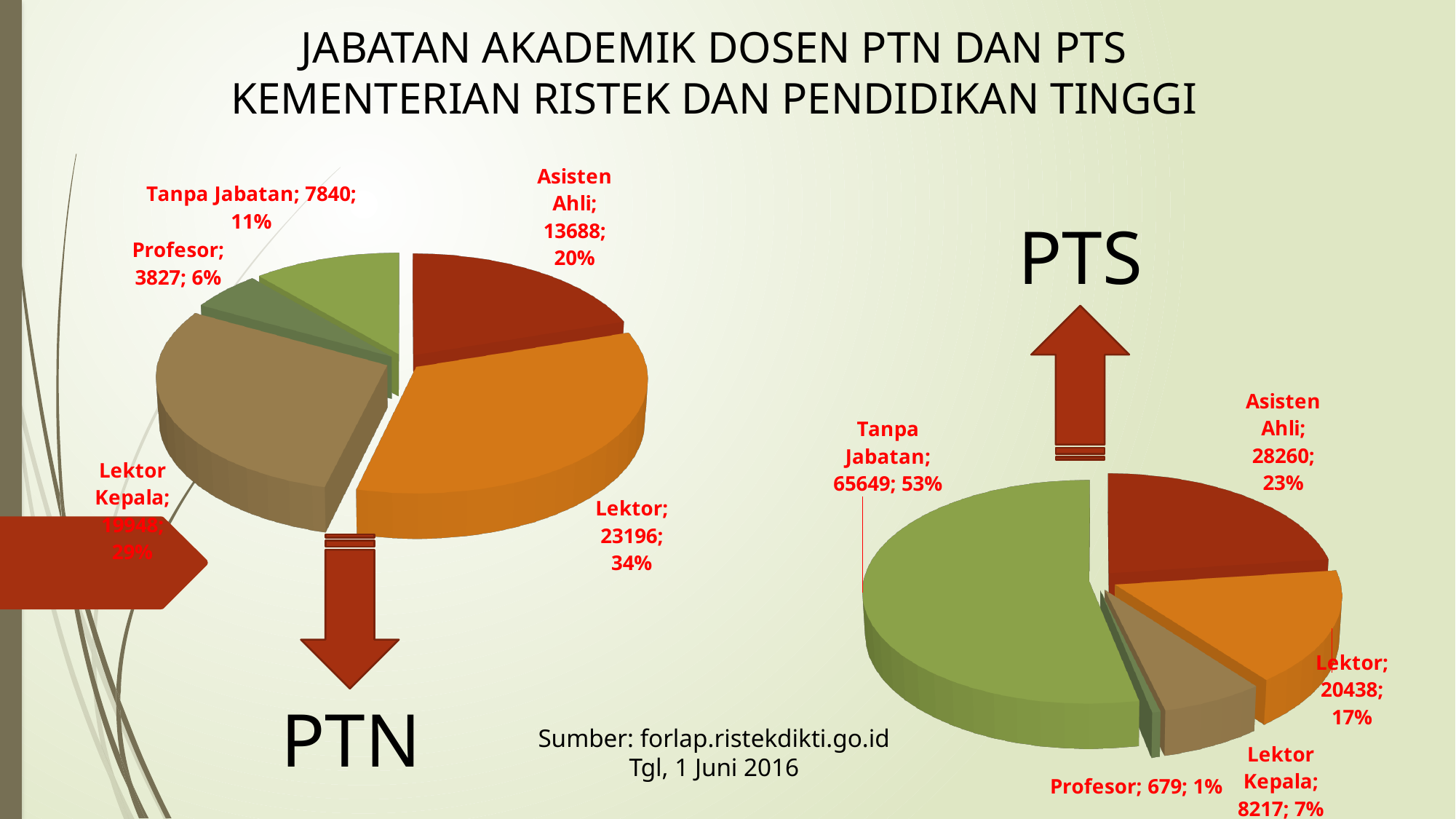
In the PTN pie chart, what share of the pie does Asisten Ahli have? 20% In the PTN pie chart, which category has the largest slice? Lektor In the PTN pie chart, what is the difference between the values for Tanpa Jabatan and Profesor? 4013 How many categories does the PTS pie chart show? 5 In the PTN pie chart, what is the value for Profesor? 3827 In the PTN pie chart, which category has the smallest slice? Profesor What kind of chart is used for the PTN data? Pie chart In the PTS pie chart, what is the value for Tanpa Jabatan? 65649 In the PTS pie chart, which category has the smallest slice? Profesor In the PTN pie chart, what is the value for Lektor? 23196 In the PTS pie chart, what share of the pie does Lektor have? 17% In the PTS pie chart, which is larger, Asisten Ahli or Lektor Kepala? Asisten Ahli